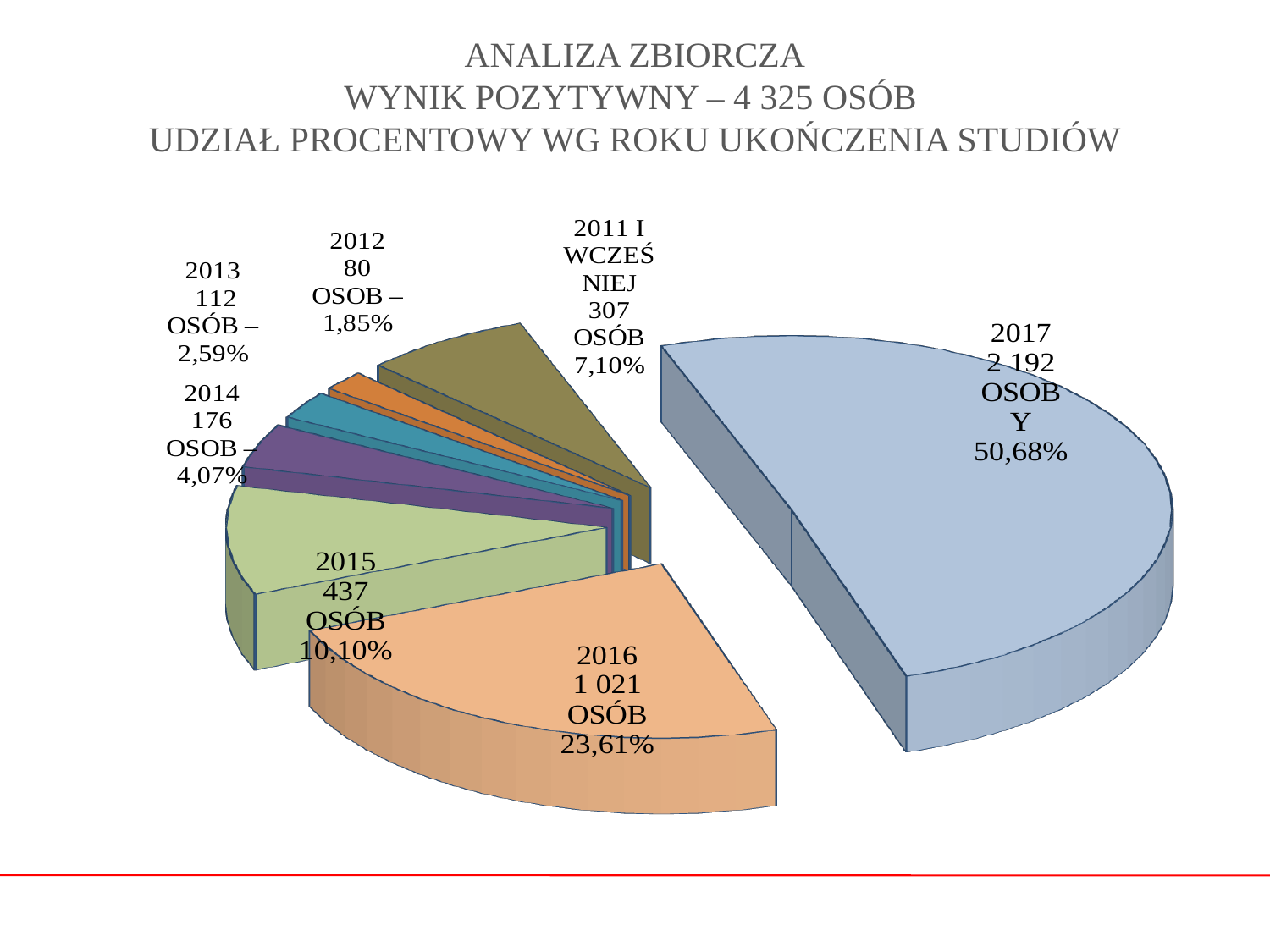
What percentage share does the 2017 slice have? 50,68% What is the difference in number of people between the 2017 and 2016 slices? 1 171 What kind of chart is shown on the slide? pie chart Which year has the smallest slice of the pie? 2012 What percentage share does the 2015 slice have? 10,10% What total number of people with a positive result is stated in the chart title? 4 325 How many people (osób) are in the 2016 slice? 1 021 Which slice is larger, 2014 or 2013? 2014 How many people are in the '2011 i wcześniej' slice? 307 Which year has the largest slice of the pie? 2017 What percentage share does the 2014 slice have? 4,07% How many slices does the pie chart have? 7